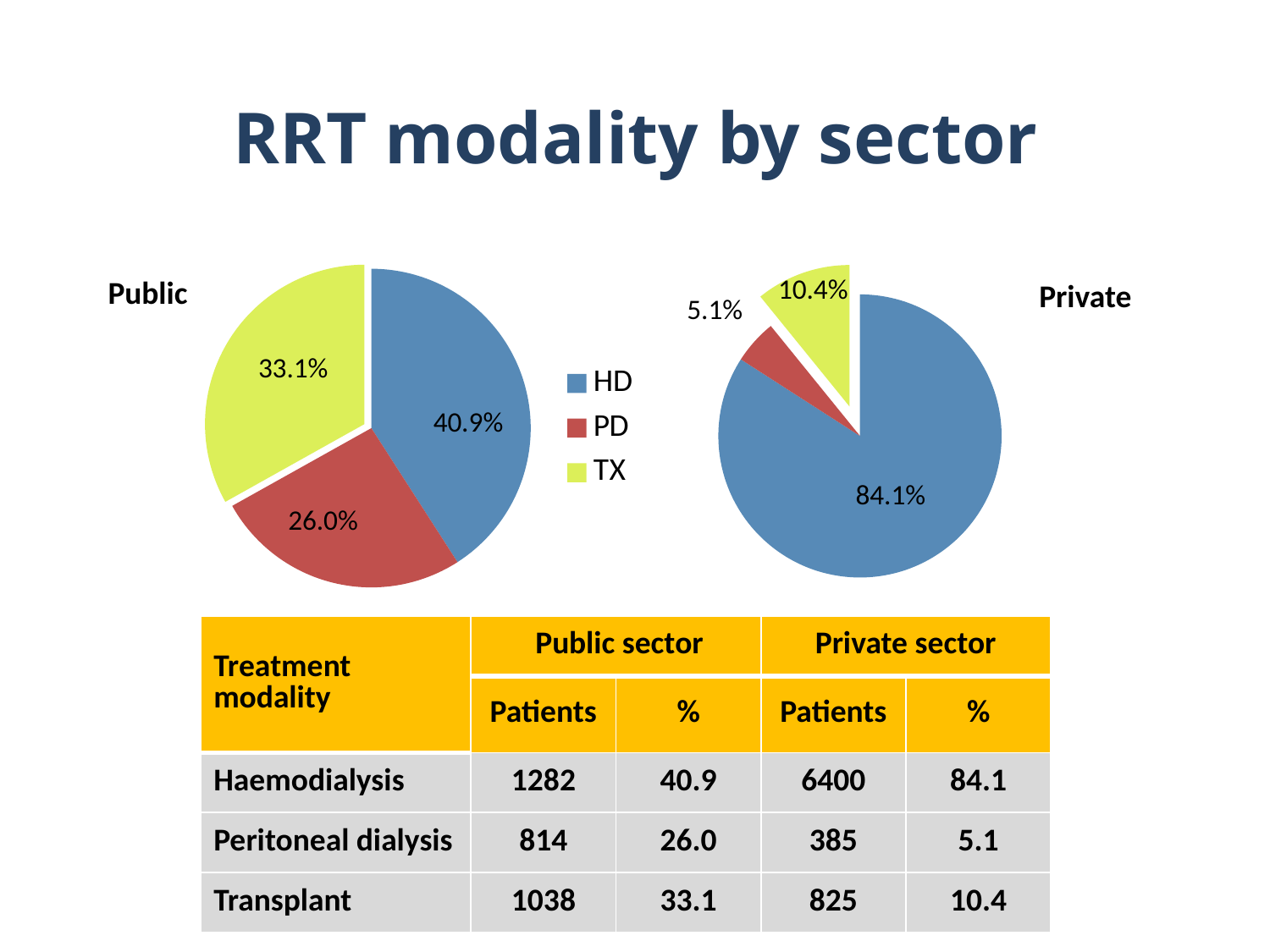
In the Public pie chart, what share does PD have? 26.0% In the Public pie chart, which is larger, the share for TX or the share for PD? TX How many entries does the legend between the two pie charts list? 3 In the Public pie chart, which modality has the largest share? HD In the Private pie chart, what share does PD have? 5.1% What type of chart is used to show the Public sector data? Pie chart In the Public pie chart, what is the difference in percentage points between the TX share and the PD share? 7.1 What is the difference in percentage points between the HD share in the Private pie chart and the HD share in the Public pie chart? 43.2 In the Private pie chart, which modality has the smallest share? PD In the Private pie chart, what share does TX have? 10.4% How many slices does the Private pie chart have? 3 In the Public pie chart, what share does HD have? 40.9%